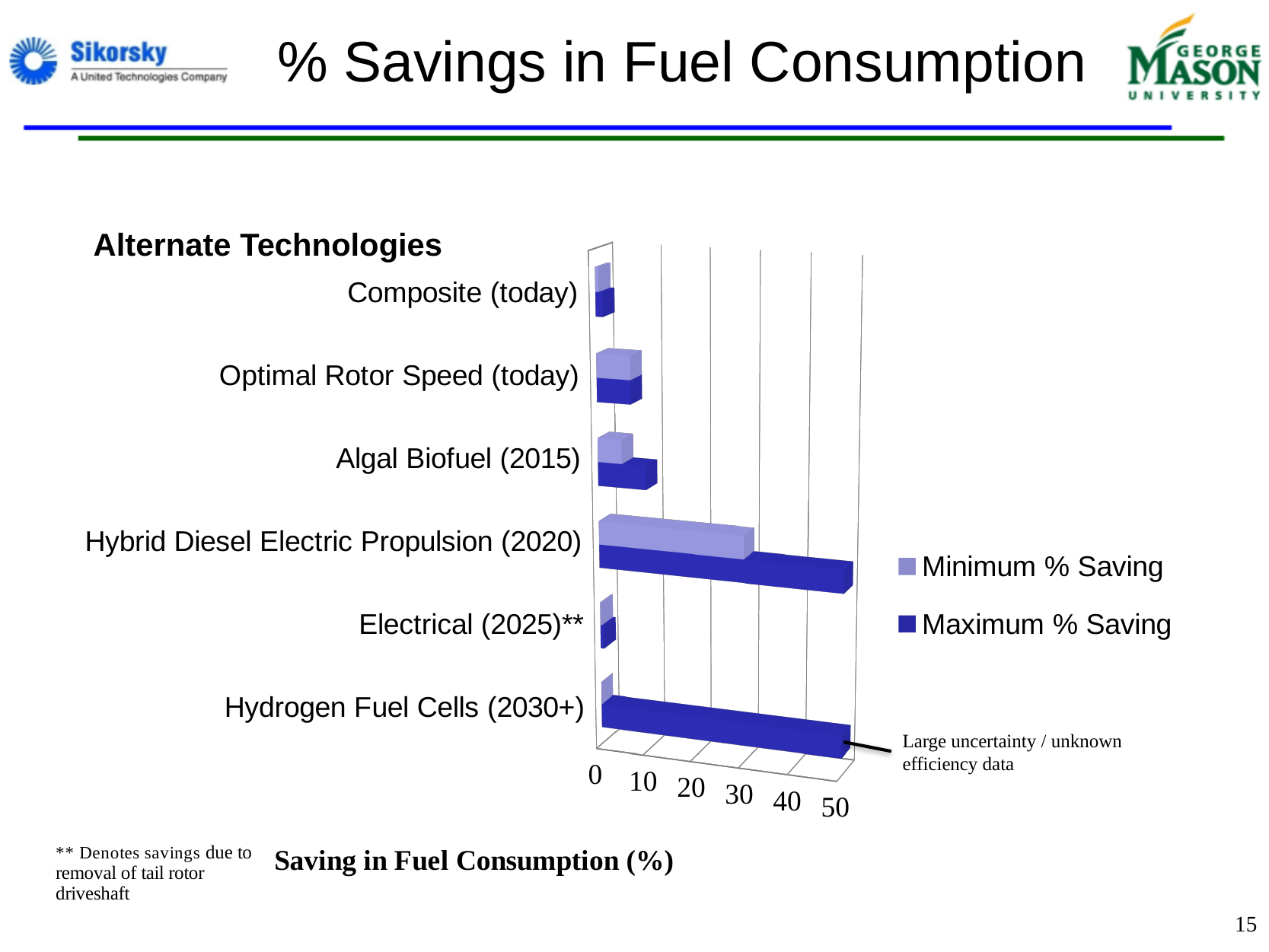
Is the Maximum % Saving for Composite (today) greater or less than 10? less Which technology has the highest Minimum % Saving? Hybrid Diesel Electric Propulsion (2020) What is the title of the chart's horizontal axis? Saving in Fuel Consumption (%) For Hydrogen Fuel Cells (2030+), which is larger: the Minimum % Saving or the Maximum % Saving? Maximum % Saving Is the Maximum % Saving for Optimal Rotor Speed (today) greater or less than 20? less What kind of chart is shown on the slide? bar chart How many alternate technologies (categories) are plotted in the chart? 6 Which series is shown in the lighter purple colour in the legend? Minimum % Saving Which is larger: the Minimum % Saving for Hybrid Diesel Electric Propulsion (2020) or for Algal Biofuel (2015)? Hybrid Diesel Electric Propulsion (2020) How many series does the chart's legend list? 2 Is the Minimum % Saving for Hybrid Diesel Electric Propulsion (2020) greater or less than 20? greater